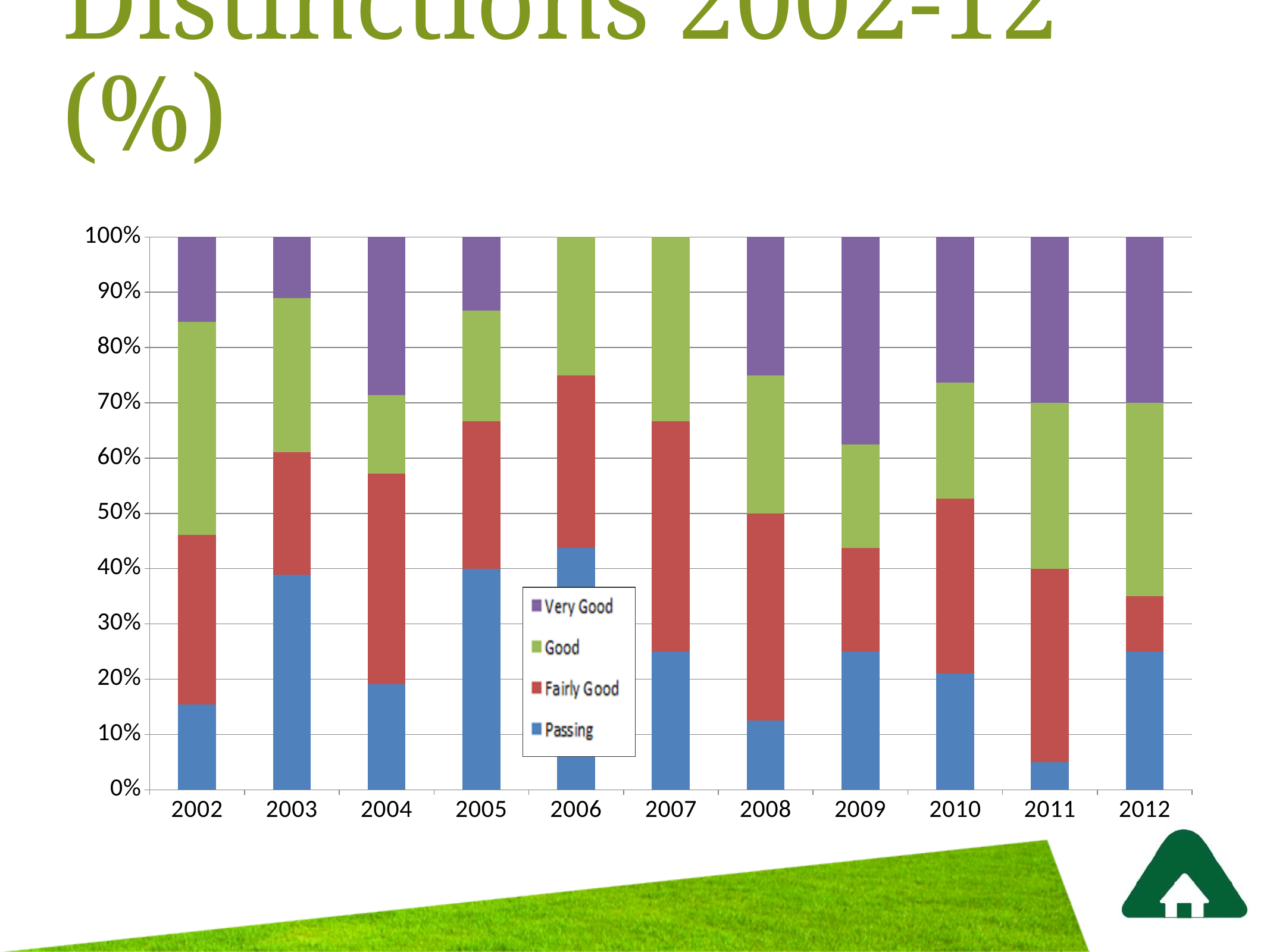
How many series does the legend list? 4 Which series does the legend list first? Very Good Which years have no Very Good segment at all? 2006 and 2007 Which year has the larger Passing share, 2002 or 2003? 2003 Is the Passing share for 2003 greater or less than 30%? greater Which year has the largest Very Good share? 2009 How many years are shown along the x axis? 11 Is the Passing share for 2011 greater or less than 10%? less Which year has the smallest Passing share? 2011 What kind of chart is shown on the slide? Stacked bar chart Which series forms the bottom segment of each bar? Passing Is the Passing share for 2006 greater or less than 40%? greater